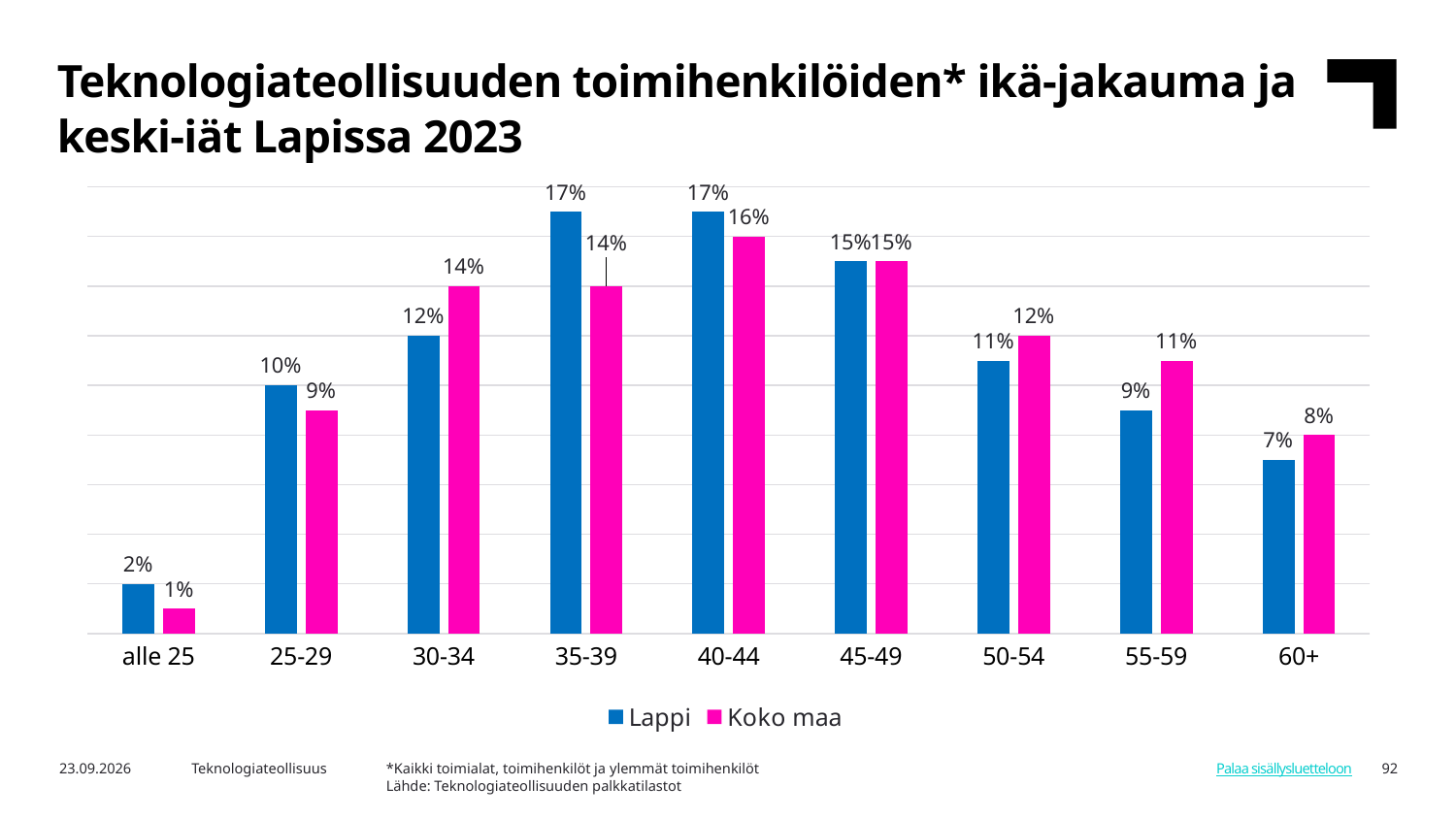
What kind of chart is shown on the slide? Bar chart Which age group has the highest value for Koko maa? 40-44 What is the difference between the Lappi values for 25-29 and 45-49? 5% Which age group has the lowest value for Lappi? alle 25 What is the value for Lappi in the 60+ age group? 7% Which colour represents the Koko maa series? Pink How many age groups are shown on the x axis? 9 What is the value for Koko maa in the 55-59 age group? 11% What is the difference between Lappi and Koko maa in the 35-39 age group? 3% Which is larger in the 50-54 age group, Lappi or Koko maa? Koko maa What is the value for Lappi in the 30-34 age group? 12% How many series does the legend list? 2